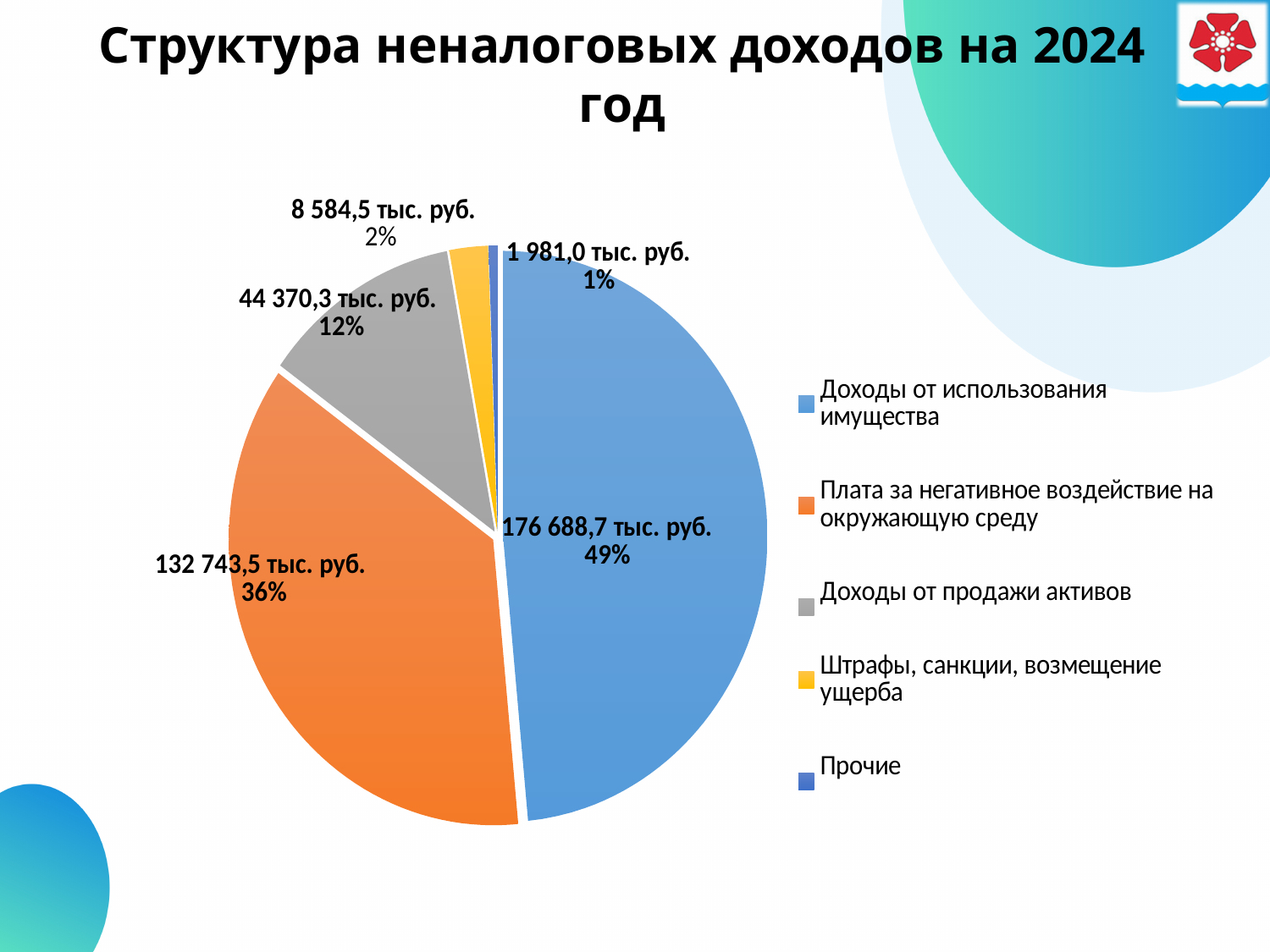
How many categories does the pie chart have? 5 What is the value for "Доходы от продажи активов"? 44 370,3 тыс. руб. Which category has the largest slice? Доходы от использования имущества What is the value for "Плата за негативное воздействие на окружающую среду"? 132 743,5 тыс. руб. What type of chart is shown on the slide? pie chart What is the value for "Штрафы, санкции, возмещение ущерба"? 8 584,5 тыс. руб. What share of the pie does "Плата за негативное воздействие на окружающую среду" represent? 36% Which category has the smallest slice? Прочие What is the value for "Доходы от использования имущества"? 176 688,7 тыс. руб. What is the title of the slide? Структура неналоговых доходов на 2024 год What is the value for "Прочие"? 1 981,0 тыс. руб. What share of the pie does "Доходы от продажи активов" represent? 12%